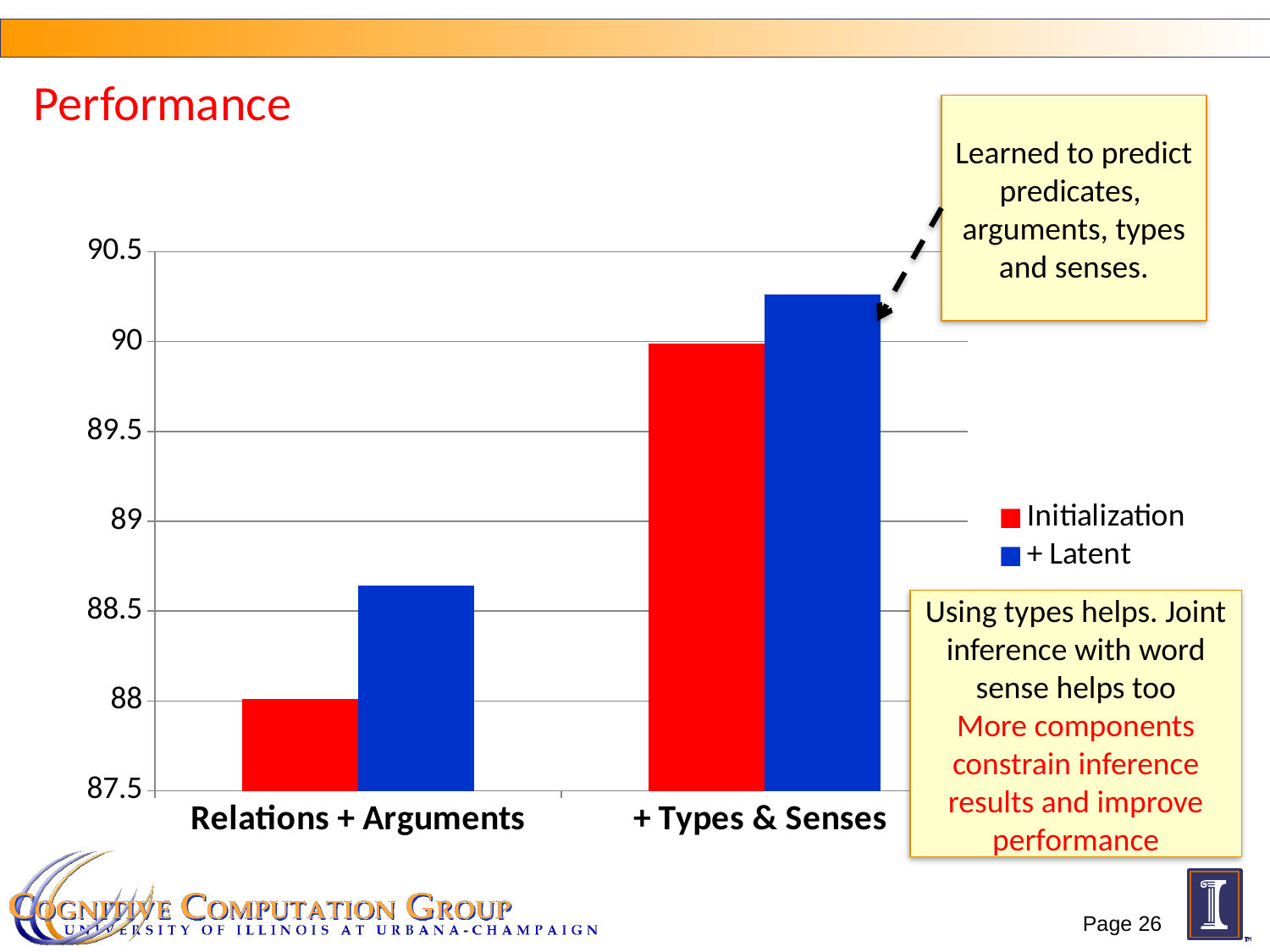
Which category and series has the shortest bar in the chart? Initialization for Relations + Arguments Is the Initialization value for + Types & Senses greater or less than 89.5? greater How many categories are shown on the x axis of the chart? 2 Is the + Latent value for + Types & Senses greater or less than 90? greater How many series does the chart legend list? 2 For the + Types & Senses category, which series has the larger value, Initialization or + Latent? + Latent For the Relations + Arguments category, which series has the larger value, Initialization or + Latent? + Latent Is the + Latent value for Relations + Arguments greater or less than 88.5? greater Which category and series has the tallest bar in the chart? + Latent for + Types & Senses What colour represents the + Latent series in the chart? blue What kind of chart is shown on the slide? bar chart Do the Initialization values rise or fall from Relations + Arguments to + Types & Senses? rise